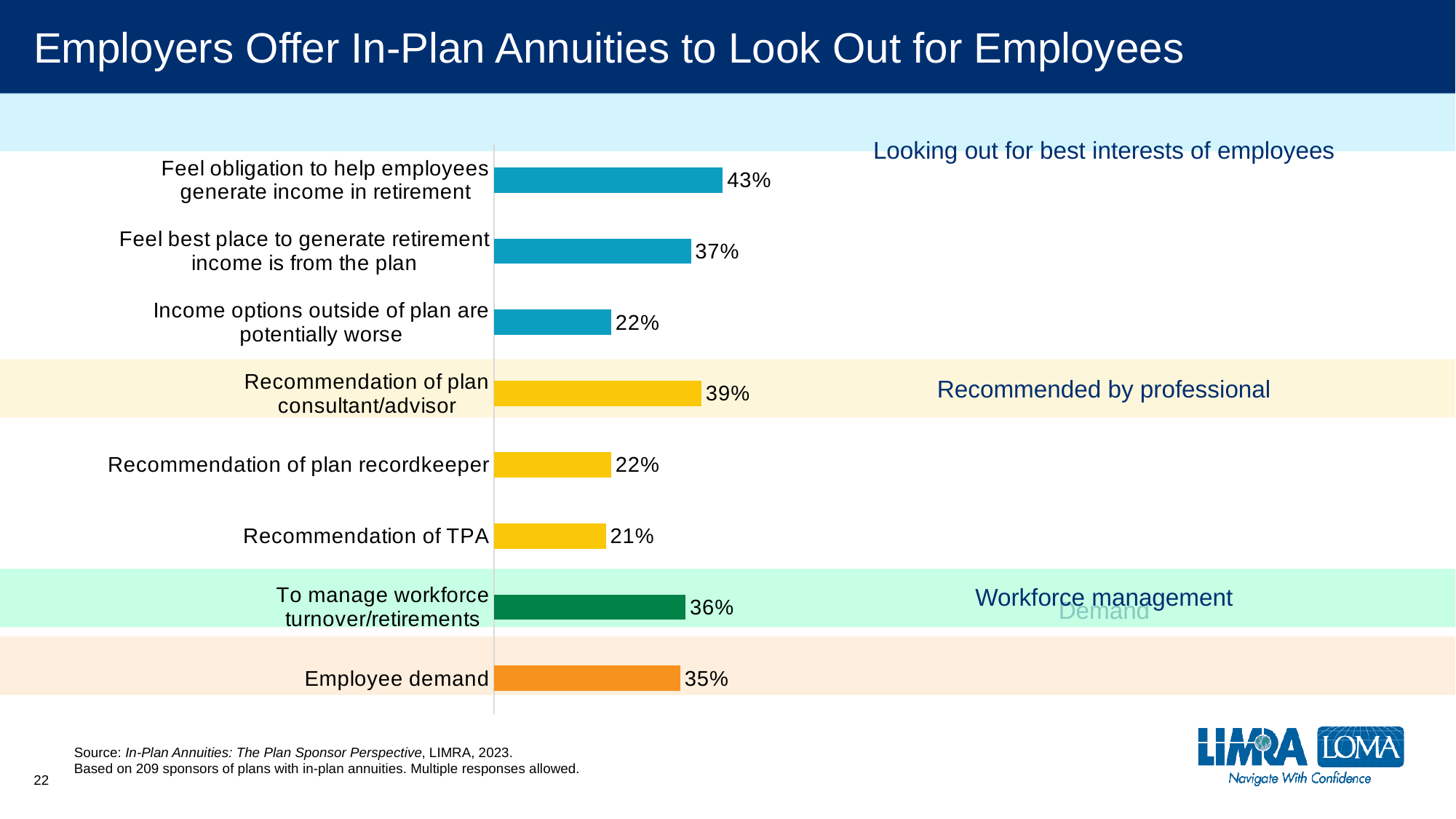
Which category has the lowest value? Recommendation of TPA Which category has the highest value? Feel obligation to help employees generate income in retirement What is the value for 'To manage workforce turnover/retirements'? 36% What is the value for 'Recommendation of plan consultant/advisor'? 39% What kind of chart is shown on the slide? Bar chart What is the value for 'Employee demand'? 35% What is the difference between 'Recommendation of plan recordkeeper' and 'Recommendation of TPA'? 1 percentage point What percentage of sponsors cited 'Feel obligation to help employees generate income in retirement'? 43% Which is larger: 'Recommendation of plan consultant/advisor' or 'To manage workforce turnover/retirements'? Recommendation of plan consultant/advisor How many categories are shown in the chart? 8 What is the difference between 'Feel obligation to help employees generate income in retirement' and 'Feel best place to generate retirement income is from the plan'? 6 percentage points Which group label is shown next to the yellow bars? Recommended by professional